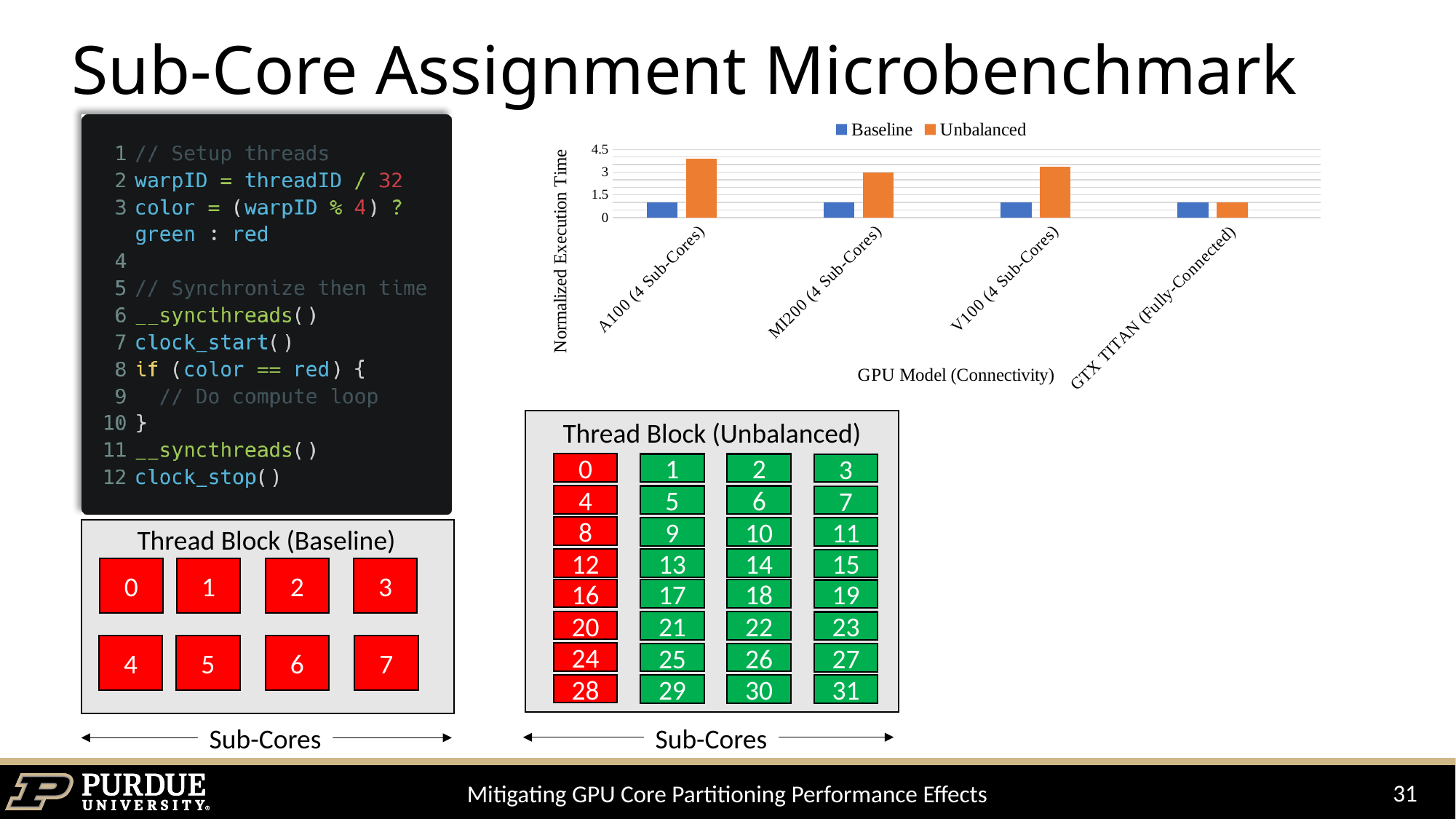
Which is larger, the Unbalanced value for A100 (4 Sub-Cores) or for V100 (4 Sub-Cores)? A100 (4 Sub-Cores) Is the Unbalanced value for MI200 (4 Sub-Cores) greater or less than 1.5? greater What colour are the Unbalanced bars in the chart? orange Is the Unbalanced value for GTX TITAN (Fully-Connected) greater or less than 1.5? less What is the label of the chart's y axis? Normalized Execution Time Which GPU model has the lowest Unbalanced normalized execution time? GTX TITAN (Fully-Connected) Is the Unbalanced value for A100 (4 Sub-Cores) greater or less than 3? greater How many GPU model categories are shown on the x axis of the chart? 4 What kind of chart is shown on the slide? bar chart How many series does the chart legend list? 2 Which GPU model has the highest Unbalanced normalized execution time? A100 (4 Sub-Cores)